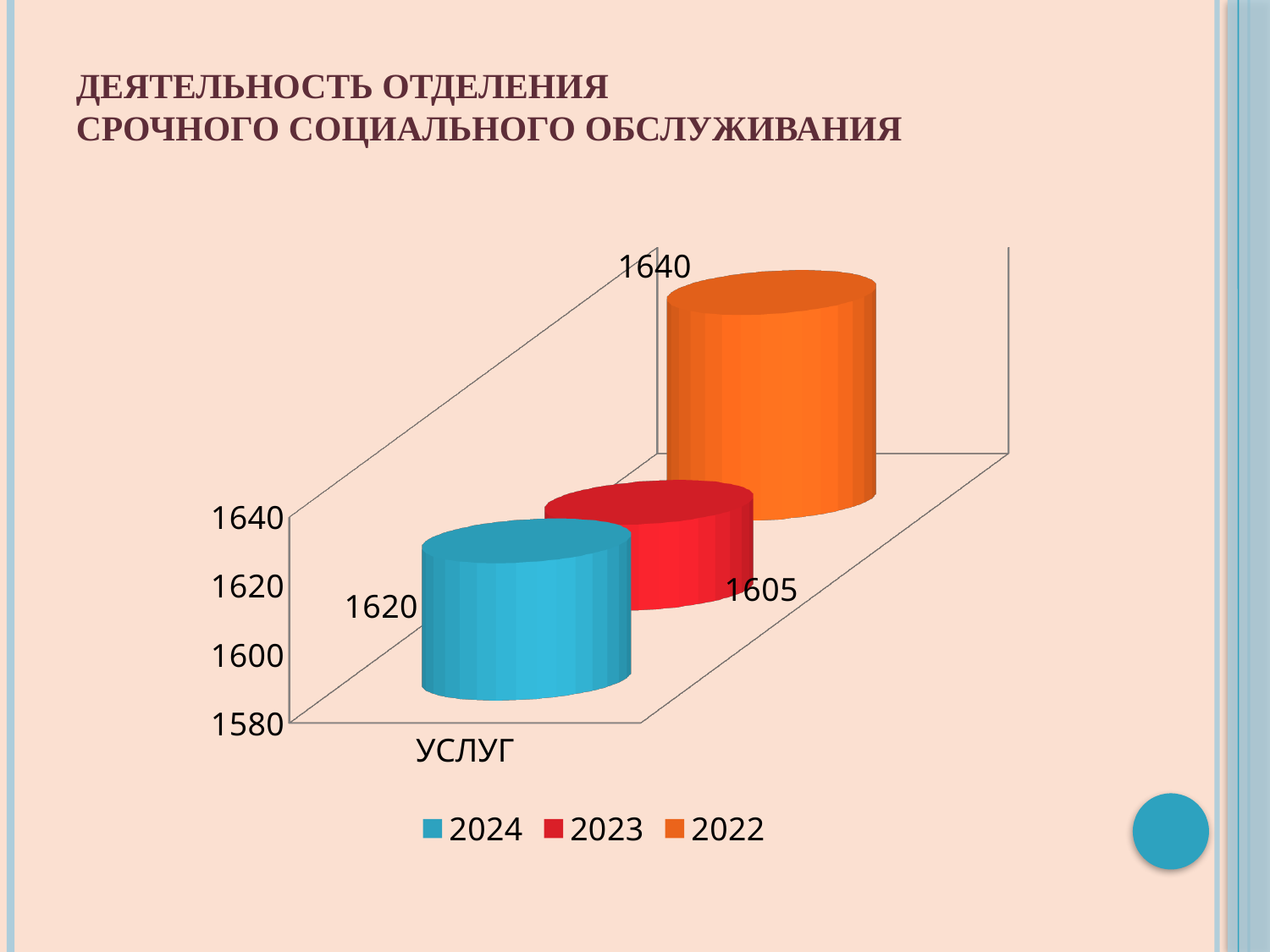
What is the value for 2024 in the chart? 1620 What is the value for 2023 in the chart? 1605 Which year has the lowest value in the chart? 2023 What is the difference between the values for 2022 and 2023? 35 What is the value for 2022 in the chart? 1640 What is the difference between the values for 2024 and 2023? 15 Which is larger, the value for 2024 or the value for 2023? 2024 What is the category label shown on the x axis of the chart? УСЛУГ Is the value for 2023 greater or less than 1620? less Which year has the highest value in the chart? 2022 What kind of chart is shown on the slide? bar chart How many series does the legend list? 3